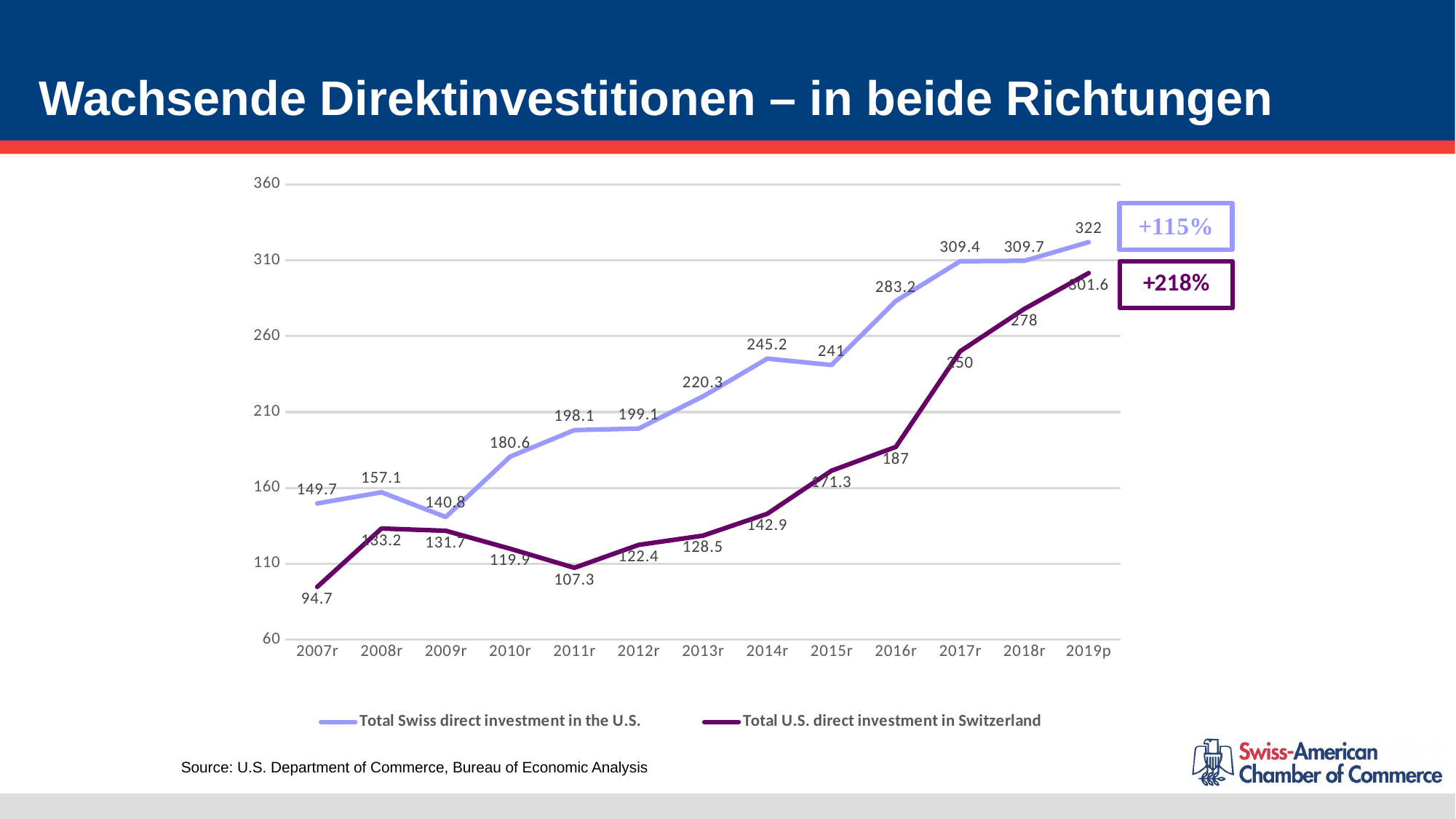
In which year is Total Swiss direct investment in the U.S. highest? 2019p What is the value of Total Swiss direct investment in the U.S. for 2019p? 322 What is the value of Total Swiss direct investment in the U.S. for 2014r? 245.2 In which year is Total U.S. direct investment in Switzerland lowest? 2007r In 2012r, which series has the larger value: Total Swiss direct investment in the U.S. or Total U.S. direct investment in Switzerland? Total Swiss direct investment in the U.S. How many years are shown on the x axis of the chart? 13 What is the value of Total U.S. direct investment in Switzerland for 2017r? 250 By how much did Total Swiss direct investment in the U.S. increase from 2009r to 2010r? 39.8 In which year is Total Swiss direct investment in the U.S. lowest? 2009r How many series does the legend list? 2 What kind of chart is shown on the slide? Line chart What is the value of Total U.S. direct investment in Switzerland for 2007r? 94.7